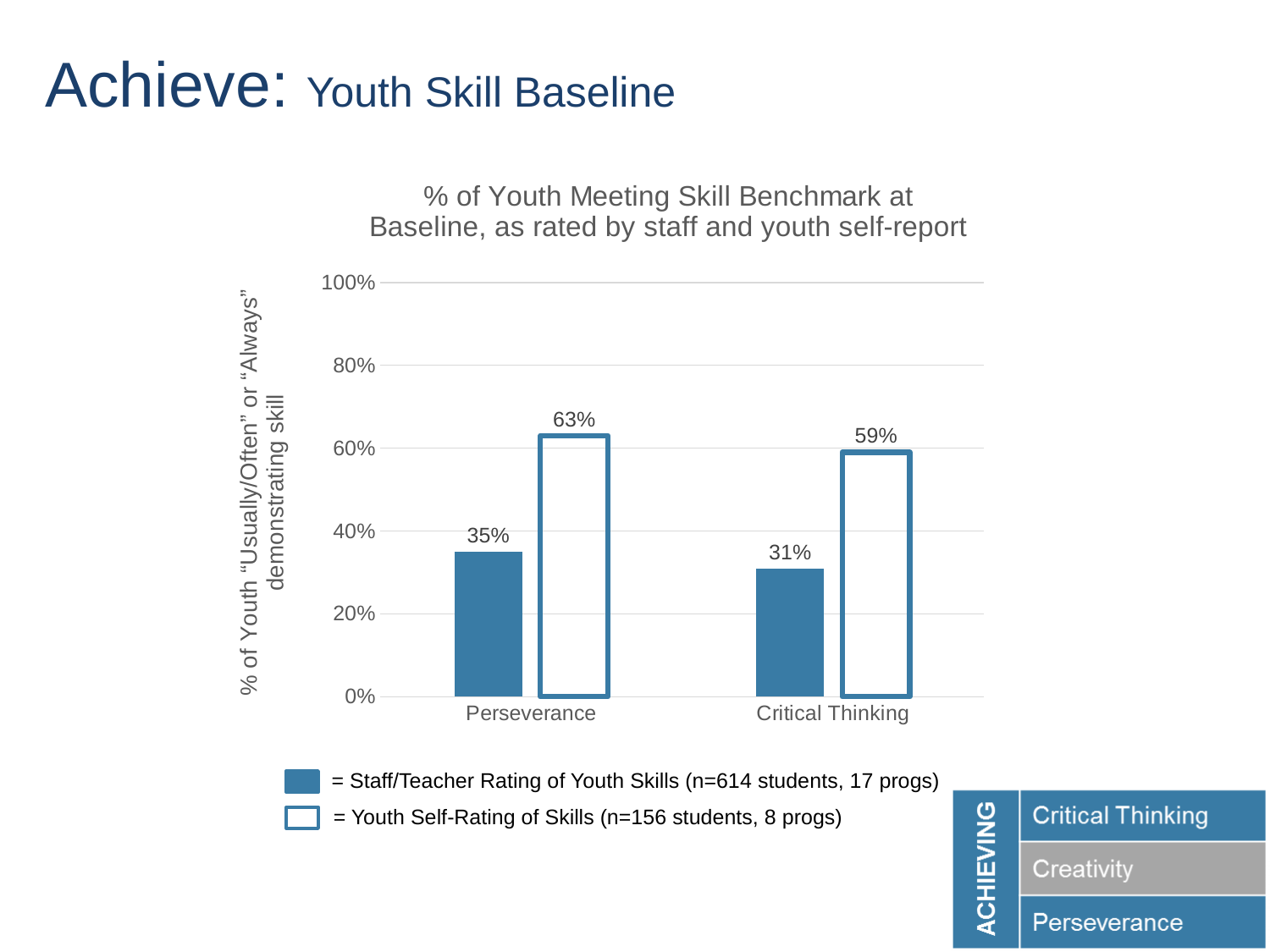
What is the Staff/Teacher Rating value for Perseverance? 35% What is the Staff/Teacher Rating value for Critical Thinking? 31% Which skill has the highest Youth Self-Rating value? Perseverance Which skill has the lowest Staff/Teacher Rating value? Critical Thinking What is the Youth Self-Rating value for Perseverance? 63% What is the Youth Self-Rating value for Critical Thinking? 59% For Critical Thinking, which is larger: the Staff/Teacher Rating or the Youth Self-Rating? Youth Self-Rating What is the difference between the Youth Self-Rating and the Staff/Teacher Rating for Critical Thinking? 28% What is the difference between the Youth Self-Rating and the Staff/Teacher Rating for Perseverance? 28% How many series does the legend list? 2 What kind of chart is shown on the slide? Bar chart How many skill categories are shown on the x axis? 2